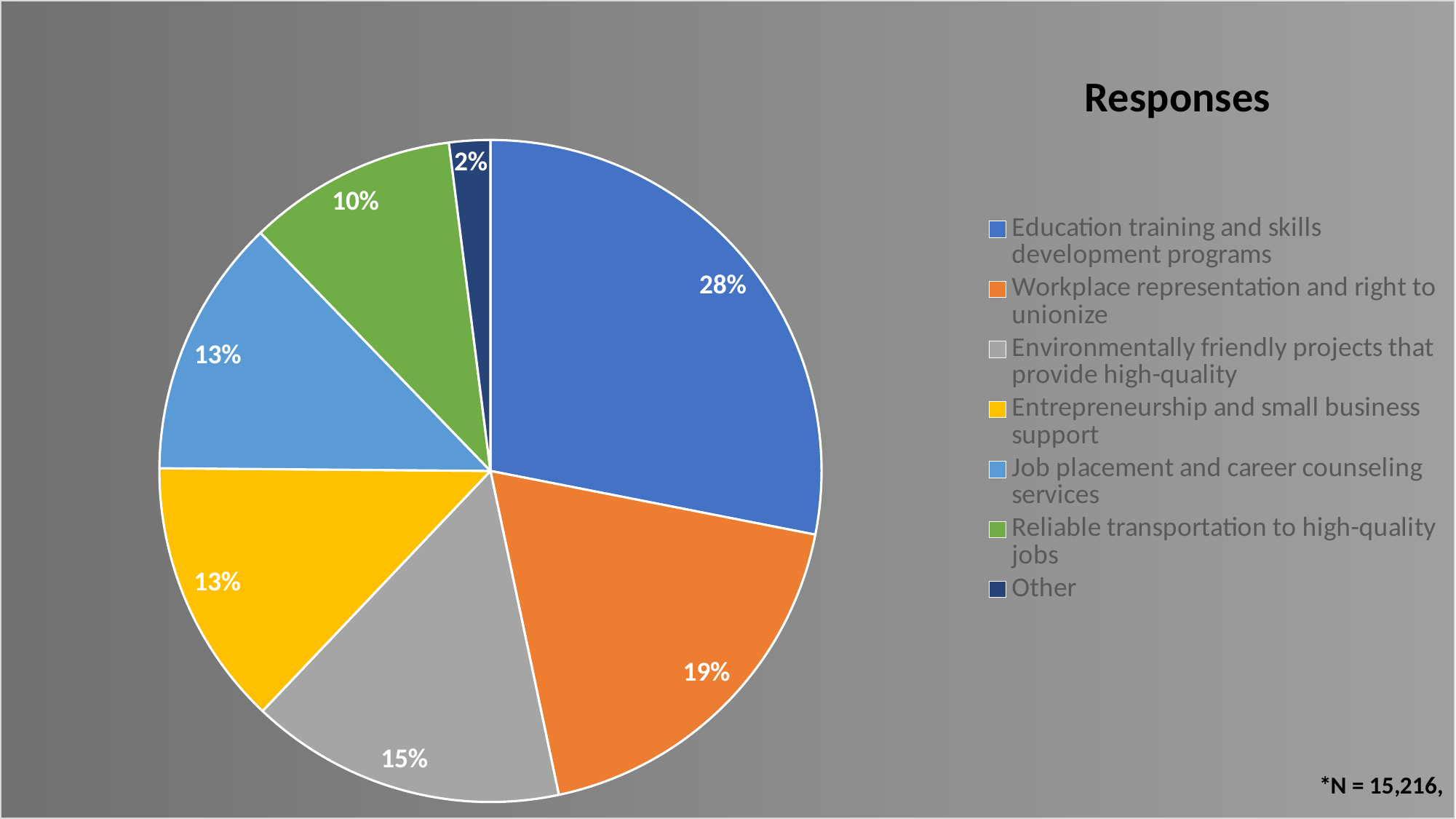
What kind of chart is shown on the slide? Pie chart Which category has the smallest share of responses? Other What share of responses is for Environmentally friendly projects that provide high-quality? 15% What is the title of the chart? Responses What share of responses is for Education training and skills development programs? 28% What share of responses is for Reliable transportation to high-quality jobs? 10% Which is larger: the share for Environmentally friendly projects that provide high-quality or the share for Reliable transportation to high-quality jobs? Environmentally friendly projects that provide high-quality How many categories does the pie chart have? 7 Which category has the largest share of responses? Education training and skills development programs What is the difference in percentage points between Education training and skills development programs and Workplace representation and right to unionize? 9